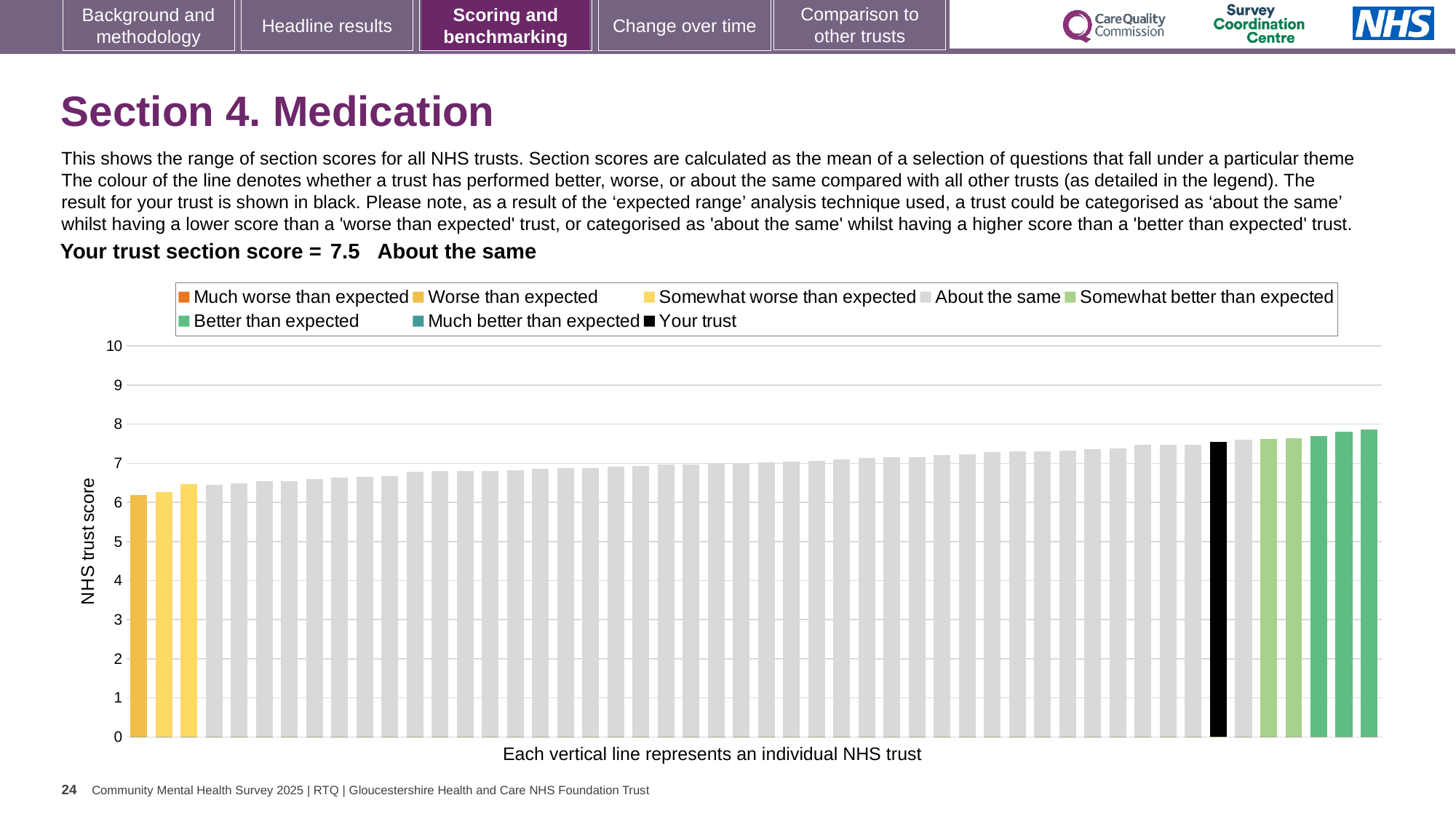
Is the value for your trust (the black bar) greater or less than 7? greater Is the value of the tallest bar greater or less than 8? less What is the label on the vertical axis of the chart? NHS trust score What is the section score for your trust shown on the slide? 7.5 Do the bar values rise or fall from left to right along the x axis? rise Is the value for your trust greater or less than the value of the tallest bar? less Which legend category does the shortest bar belong to? Worse than expected What kind of chart is shown on the slide? bar chart Is the value of the shortest bar greater or less than 7? less Which legend category does the tallest bar belong to? Better than expected How many entries does the chart legend list? 8 What colour is the bar representing your trust? black